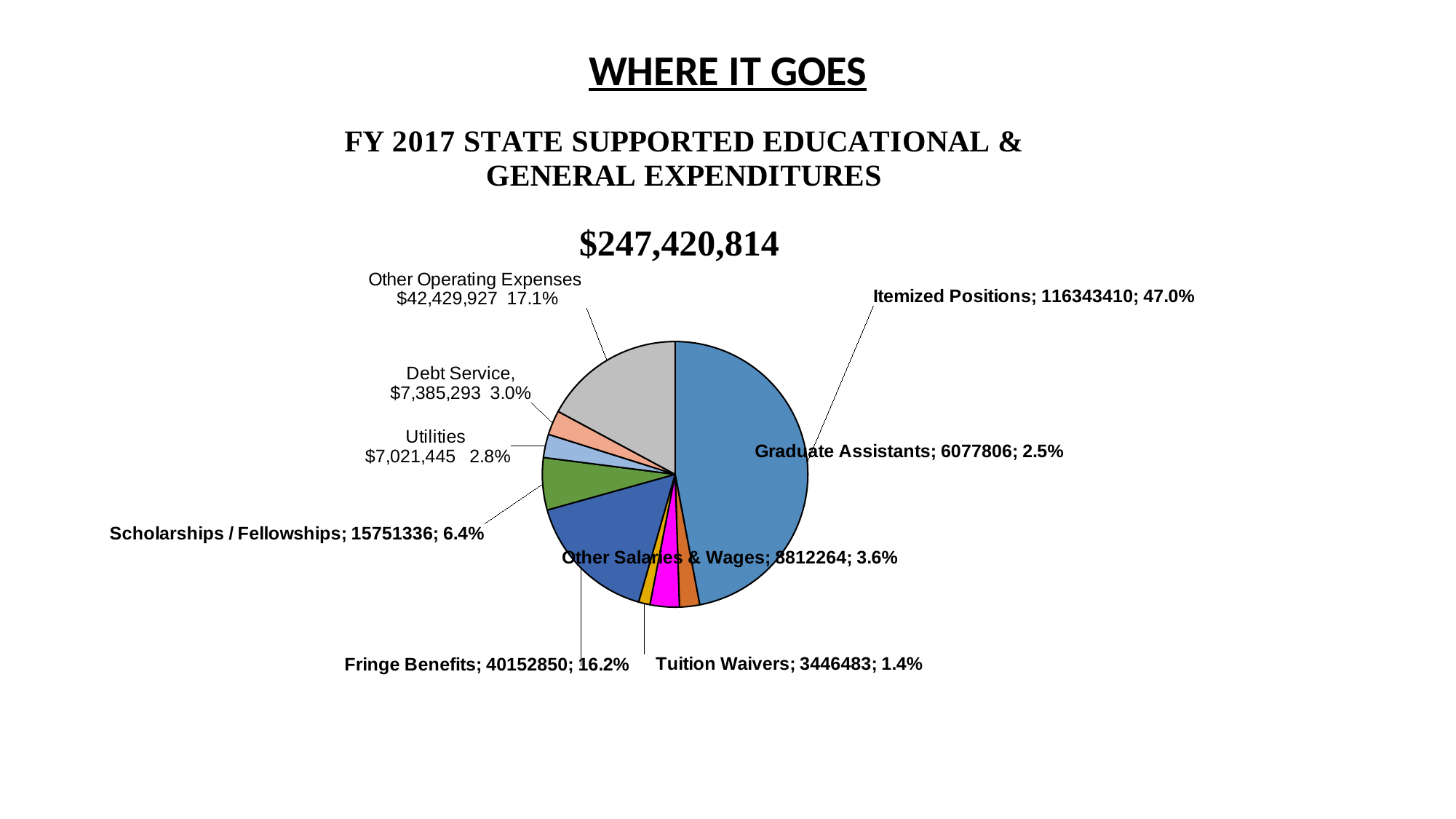
What percentage share does Utilities have? 2.8% Which category has the largest share of the pie? Itemized Positions What is the value shown for Other Operating Expenses? $42,429,927 What is the value shown for Fringe Benefits? 40152850 How many categories (slices) does the pie chart have? 9 Which category has the smallest share of the pie? Tuition Waivers What kind of chart is shown on the slide? pie chart What is the difference in percentage points between Other Operating Expenses and Fringe Benefits? 0.9% What total amount is shown above the pie chart? $247,420,814 Which is larger, Debt Service or Utilities? Debt Service What is the title of the chart? FY 2017 STATE SUPPORTED EDUCATIONAL & GENERAL EXPENDITURES What percentage share does Itemized Positions have? 47.0%